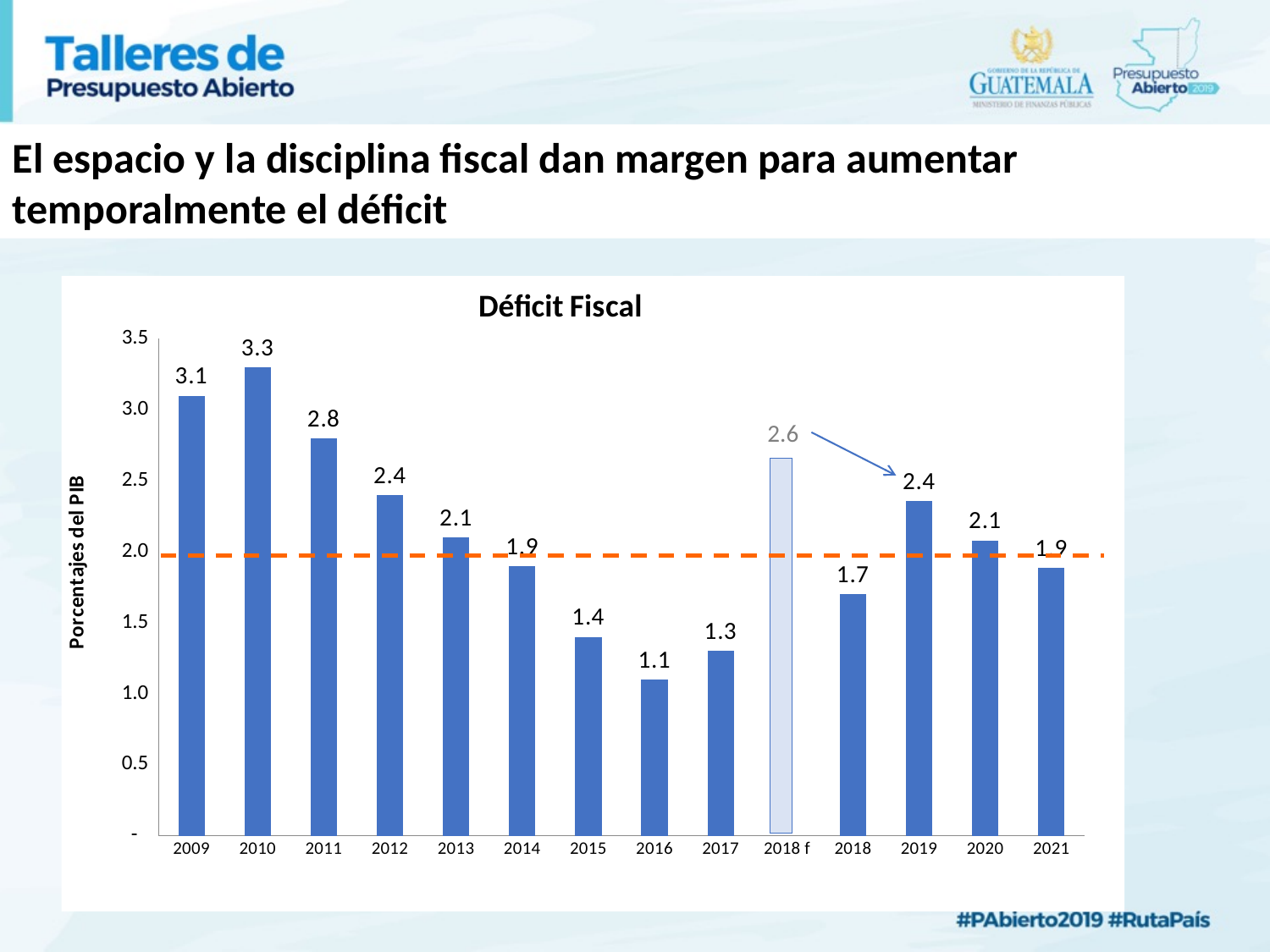
Which is larger in the Déficit Fiscal chart, the value for 2018 f or the value for 2018? 2018 f Is the value for 2015 in the Déficit Fiscal chart greater or less than 2.0? less What is the value shown for 2018 f in the Déficit Fiscal chart? 2.6 What is the difference between the values for 2010 and 2016 in the Déficit Fiscal chart? 2.2 What is the value for 2010 in the Déficit Fiscal chart? 3.3 Which year has the lowest value in the Déficit Fiscal chart? 2016 What is the value for 2021 in the Déficit Fiscal chart? 1.9 What is the value for 2016 in the Déficit Fiscal chart? 1.1 How many bars are shown in the Déficit Fiscal chart? 14 Which year has the highest value in the Déficit Fiscal chart? 2010 What kind of chart is the Déficit Fiscal chart? bar chart What is the label on the vertical axis of the Déficit Fiscal chart? Porcentajes del PIB